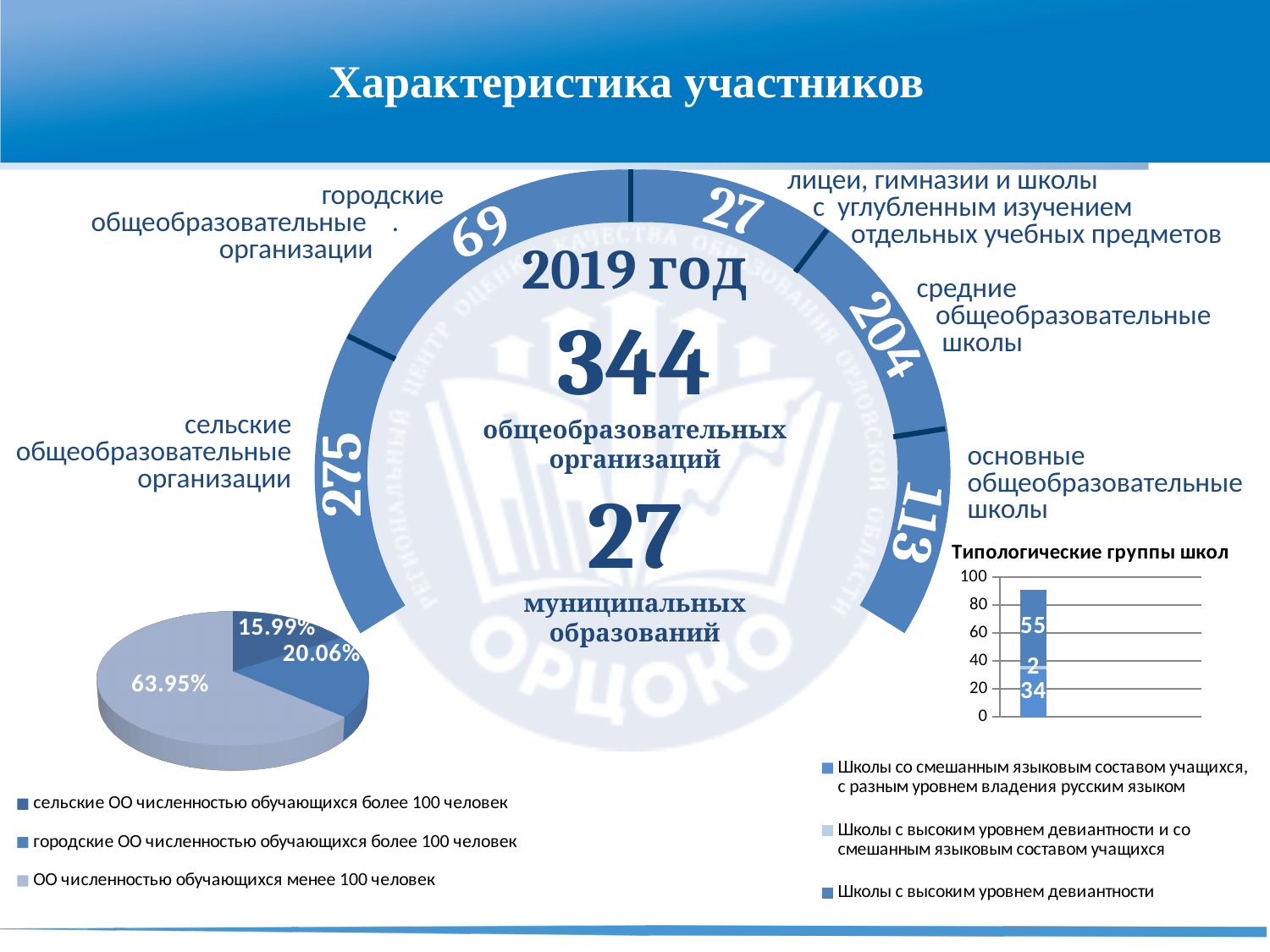
In the pie chart on the left, what is the difference between the largest slice (63.95%) and the 20.06% slice? 43.89% How many slices does the pie chart on the left have? 3 In the chart titled 'Типологические группы школ', what is the total of the stacked bar? 91 How many entries does the legend of the chart titled 'Типологические группы школ' list? 3 In the chart titled 'Типологические группы школ', what is the value for 'Школы с высоким уровнем девиантности и со смешанным языковым составом учащихся'? 2 How many entries does the legend of the pie chart on the left list? 3 What kind of chart is the chart titled 'Типологические группы школ'? bar chart What kind of chart is the chart on the left of the slide? pie chart In the pie chart on the left, what is the value of the largest slice? 63.95% In the pie chart on the left, what is the value of the smallest slice? 15.99% In the pie chart on the left, which slice is larger: the 15.99% slice or the 20.06% slice? 20.06% In the chart titled 'Типологические группы школ', what is the largest segment value in the stacked bar? 55